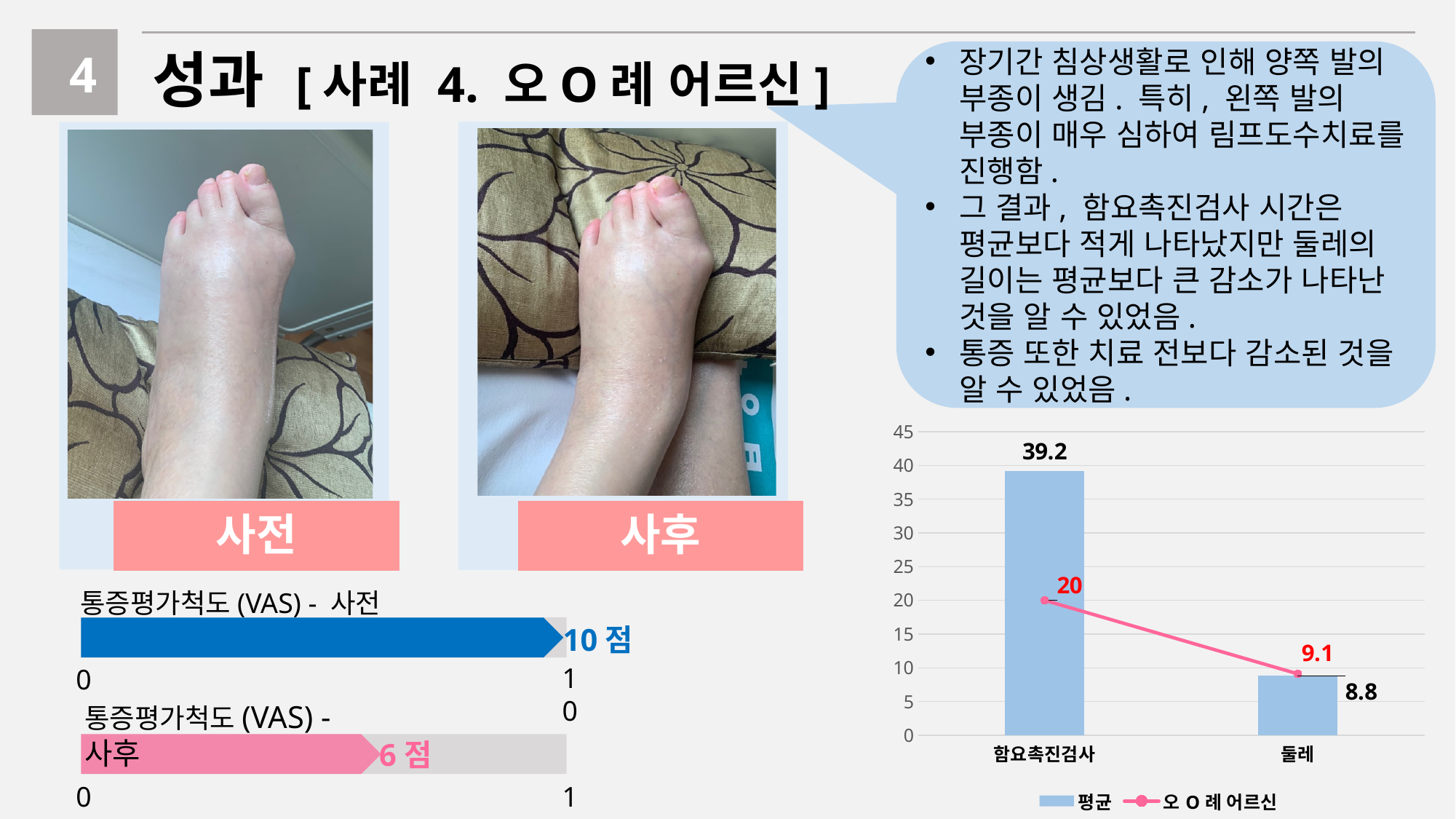
In the chart on the right, how many series does the legend list? 2 In the chart on the right, what is the 오 O 례 어르신 value for 둘레? 9.1 In the chart on the right, which category has the higher 평균 value? 함요촉진검사 In the chart on the right, what is the 오 O 례 어르신 value for 함요촉진검사? 20 In the chart on the right, for 둘레, which is larger: the 평균 value or the 오 O 례 어르신 value? 오 O 례 어르신 In the VAS bars at the bottom left, what is the 통증평가척도 (VAS) - 사후 value? 6 점 In the chart on the right, what is the 평균 value for 둘레? 8.8 In the chart on the right, what is the 평균 value for 함요촉진검사? 39.2 In the chart on the right, how many categories are shown on the x axis? 2 In the chart on the right, does the 오 O 례 어르신 line rise or fall from 함요촉진검사 to 둘레? fall In the chart on the right, what is the maximum value shown on the vertical axis? 45 In the chart on the right, what is the difference between the 평균 and 오 O 례 어르신 values for 함요촉진검사? 19.2